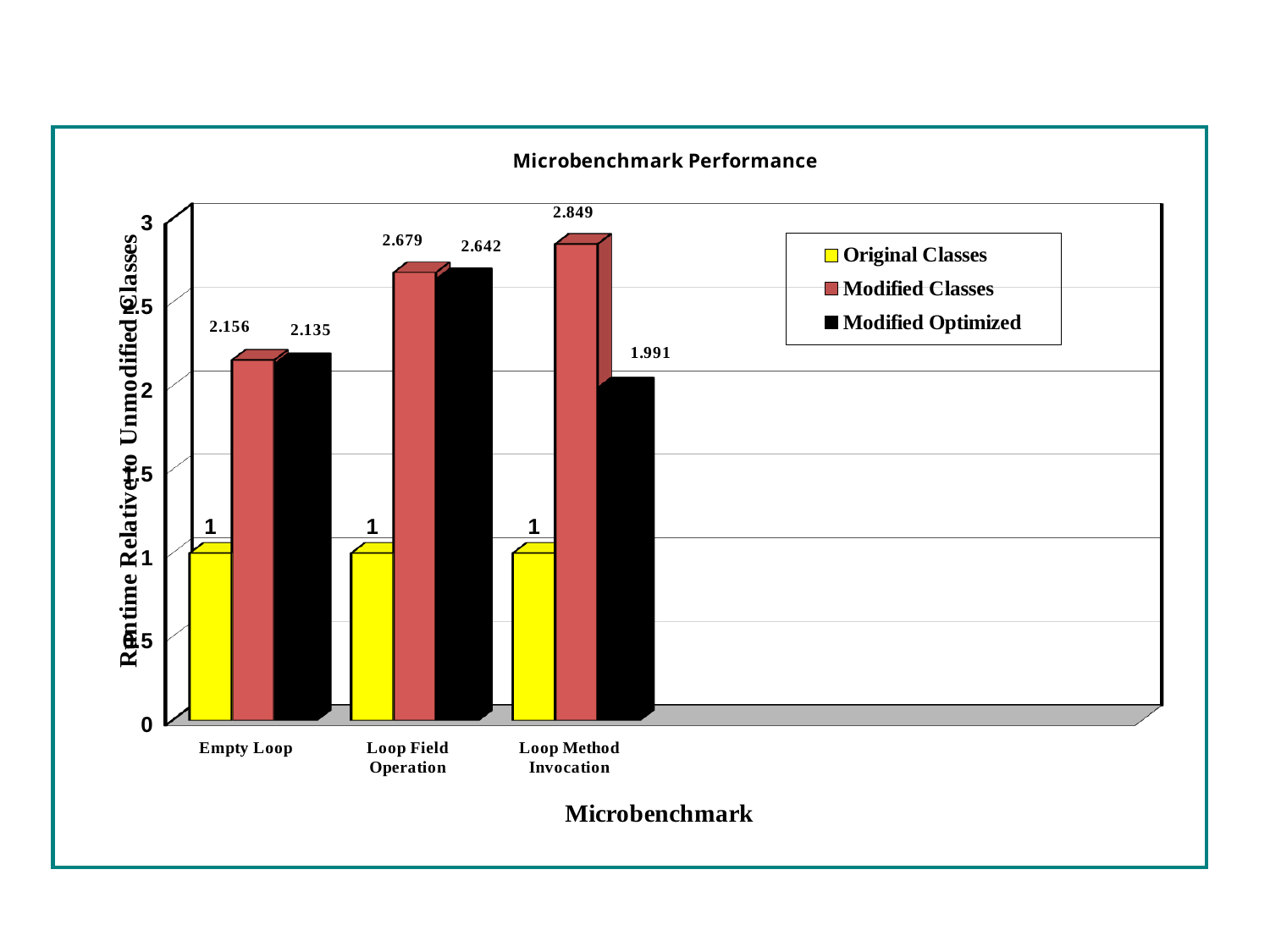
What is the value for Modified Optimized on the Loop Method Invocation benchmark? 1.991 How many benchmarks are shown on the x axis? 3 Which benchmark has the lowest Modified Optimized value? Loop Method Invocation What is the difference between the Modified Classes and Modified Optimized values for Loop Method Invocation? 0.858 What is the value for Modified Classes on the Empty Loop benchmark? 2.156 How many series does the legend list? 3 Which benchmark has the highest Modified Classes value? Loop Method Invocation What kind of chart is shown on the slide? bar chart What is the value for Modified Classes on the Loop Field Operation benchmark? 2.679 Is the Modified Optimized value for Empty Loop greater or less than 2.5? less Which is larger for Loop Field Operation: the Modified Classes value or the Modified Optimized value? Modified Classes What is the title of the chart? Microbenchmark Performance